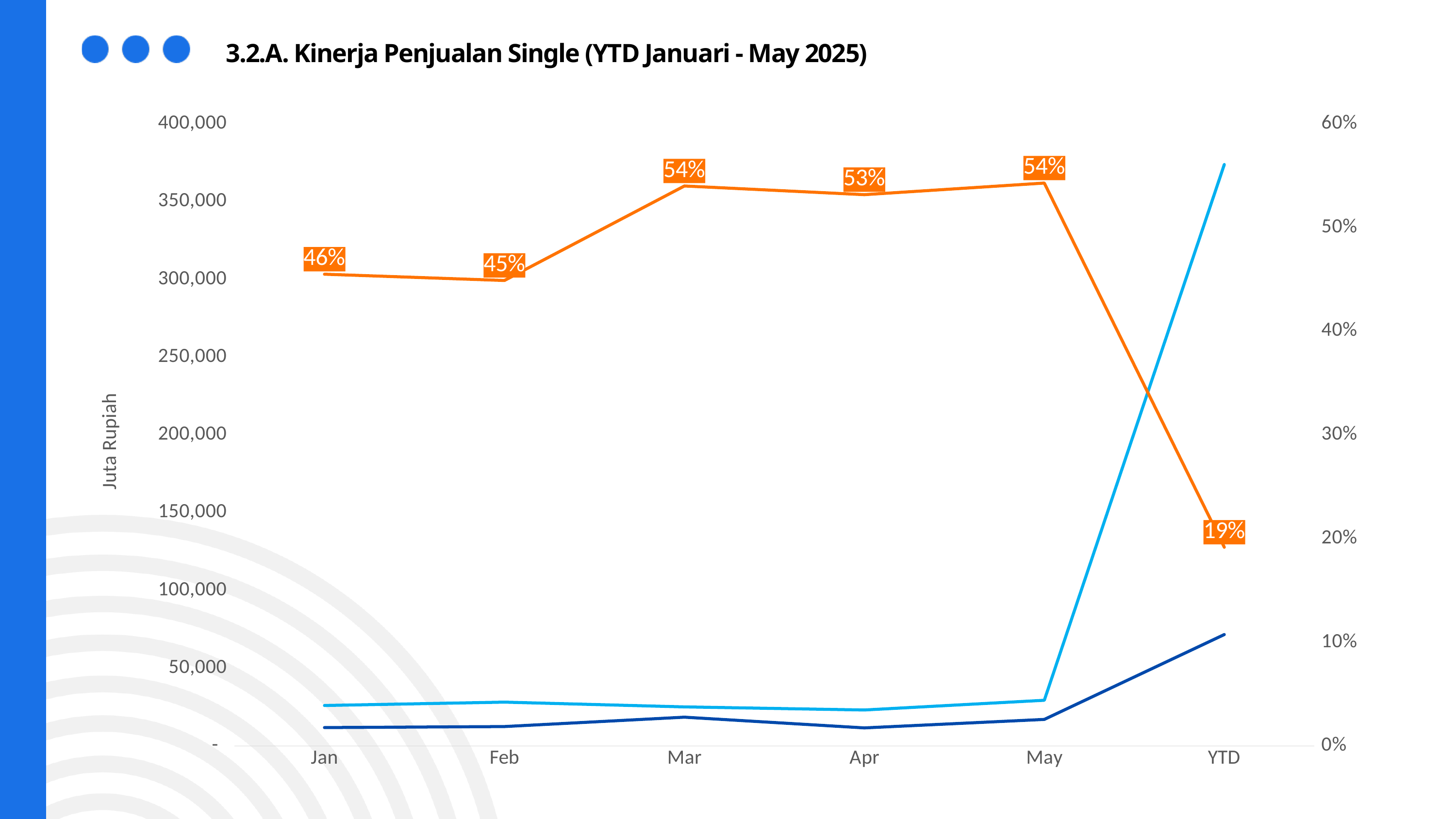
Is the value of the dark blue line at YTD greater or less than 100,000? less What is the label on the left vertical axis? Juta Rupiah At which x-axis category is the orange line lowest? YTD Does the orange line rise or fall from May to YTD? fall Is the orange line's value higher at Jan or at Feb? Jan How many categories are shown on the x axis? 6 What is the value of the orange line at Jan? 46% What is the value of the orange line at Mar? 54% What is the difference between the orange line's value at Mar and at Jan? 8 percentage points What is the value of the orange line at YTD? 19% Is the value of the light blue line at YTD greater or less than 350,000? greater What type of chart is shown on the slide? line chart